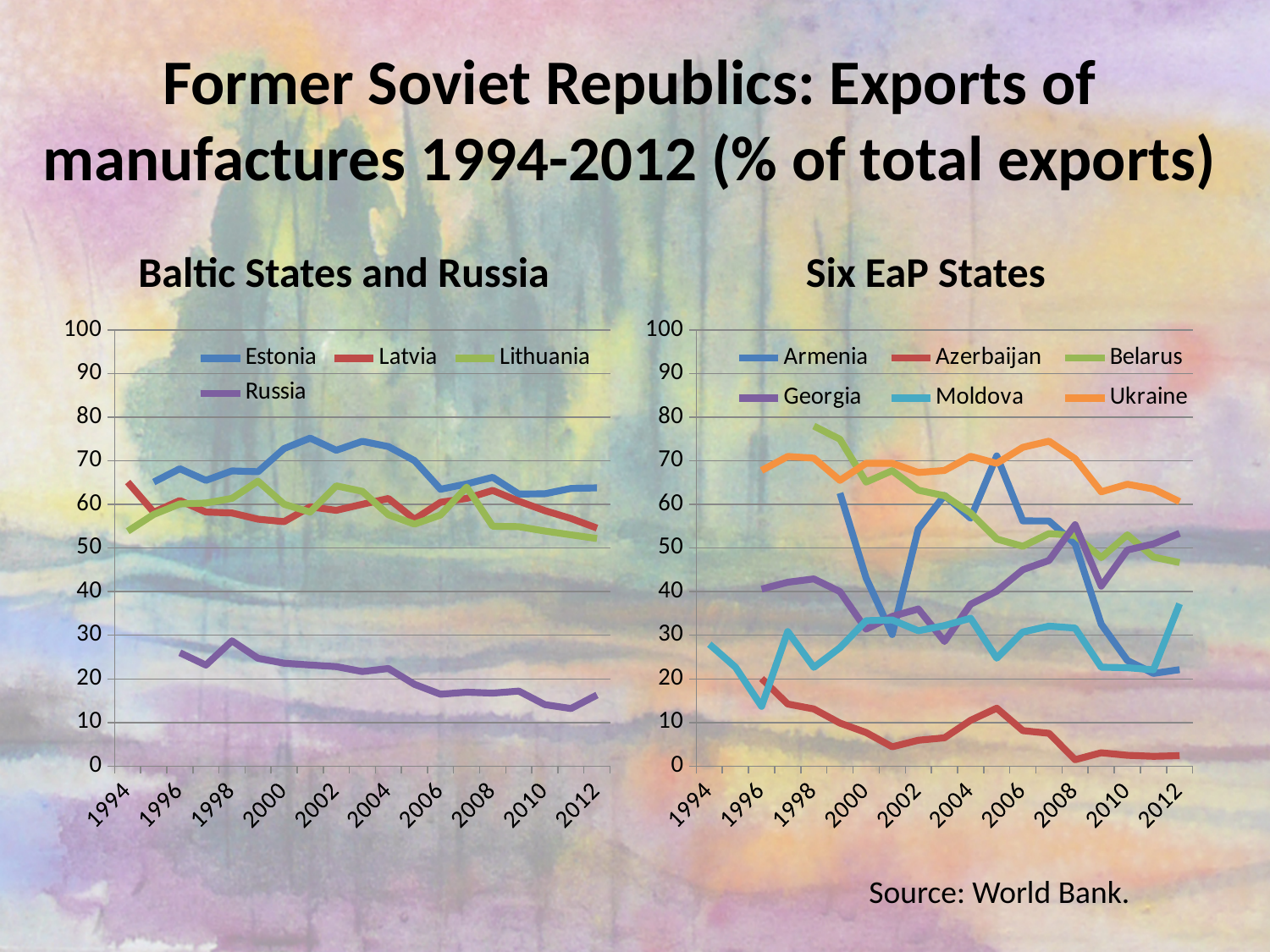
In the "Six EaP States" chart, which series has the lowest values across the whole period? Azerbaijan In the "Baltic States and Russia" chart, does the Russia line rise or fall from 1996 to 2012? fall How many series does the legend of the "Baltic States and Russia" chart list? 4 In the "Six EaP States" chart, is the value for Azerbaijan in 2012 greater or less than 10? less What is the title of the chart on the right side of the slide? Six EaP States In the "Baltic States and Russia" chart, is the value for Russia in 2012 greater or less than 20? less In the "Six EaP States" chart, does the Azerbaijan line rise or fall from 1996 to 2012? fall What kind of chart is the "Baltic States and Russia" chart? line chart In the "Six EaP States" chart, which is larger in 2012: Georgia or Moldova? Georgia How many series does the legend of the "Six EaP States" chart list? 6 In the "Baltic States and Russia" chart, is the value for Estonia in 2001 greater or less than 70? greater In the "Baltic States and Russia" chart, which series has the lowest values across the whole period? Russia